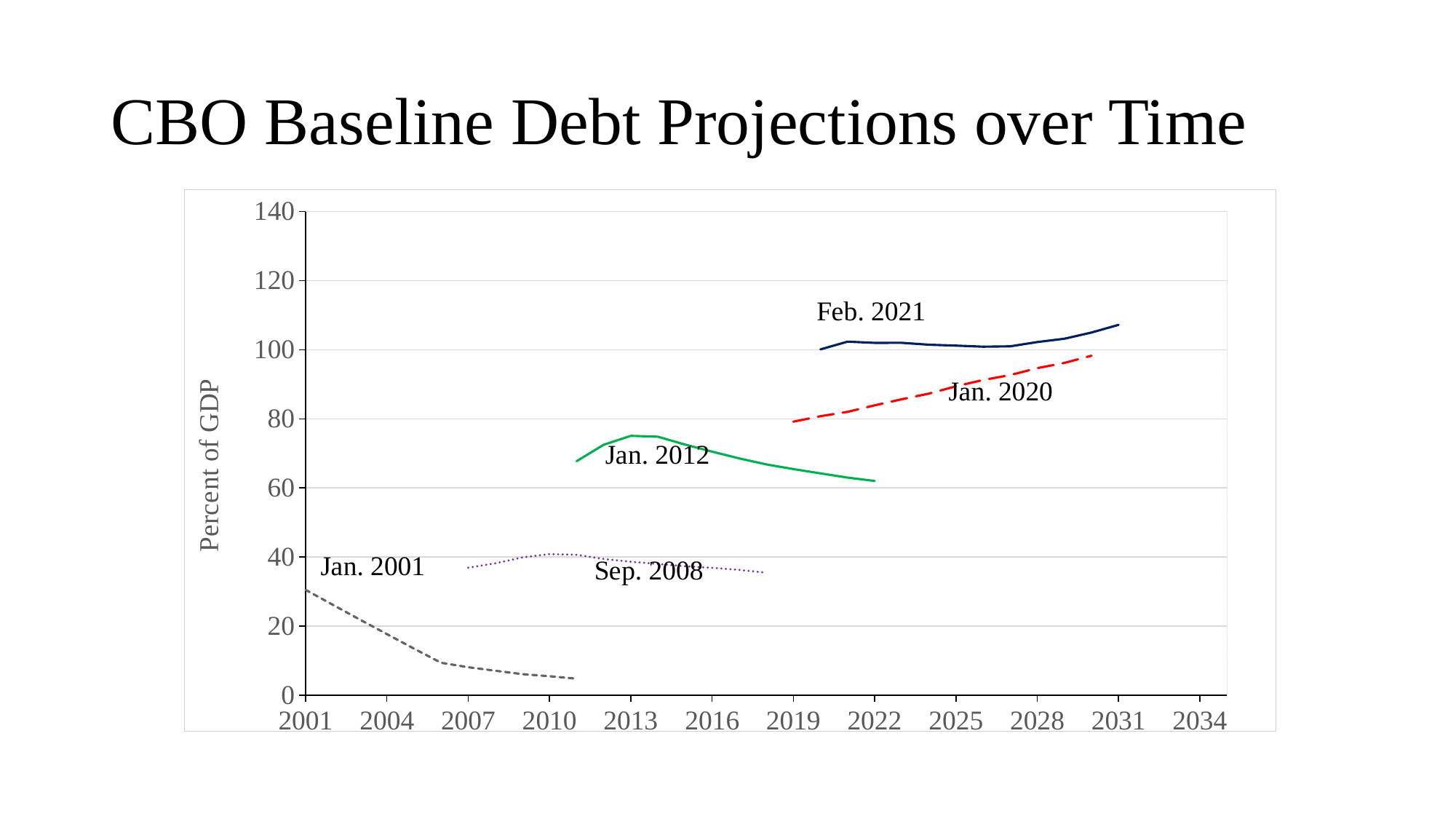
Which projection line has the lowest values on the chart? Jan. 2001 Which projection line reaches the highest values on the chart? Feb. 2021 What is the title of the chart? CBO Baseline Debt Projections over Time Is the peak value of the Jan. 2012 projection greater or less than 80? less How many projection lines are plotted on the chart? 5 Is the value of the Feb. 2021 projection in 2031 greater or less than 100? greater Does the Jan. 2001 projection line rise or fall over time? fall Which projection is higher in 2025, Feb. 2021 or Jan. 2020? Feb. 2021 Is the value of the Jan. 2001 projection in 2010 greater or less than 20? less What is the label on the vertical axis? Percent of GDP What kind of chart is shown on the slide? line chart Does the Jan. 2020 projection line rise or fall over time? rise